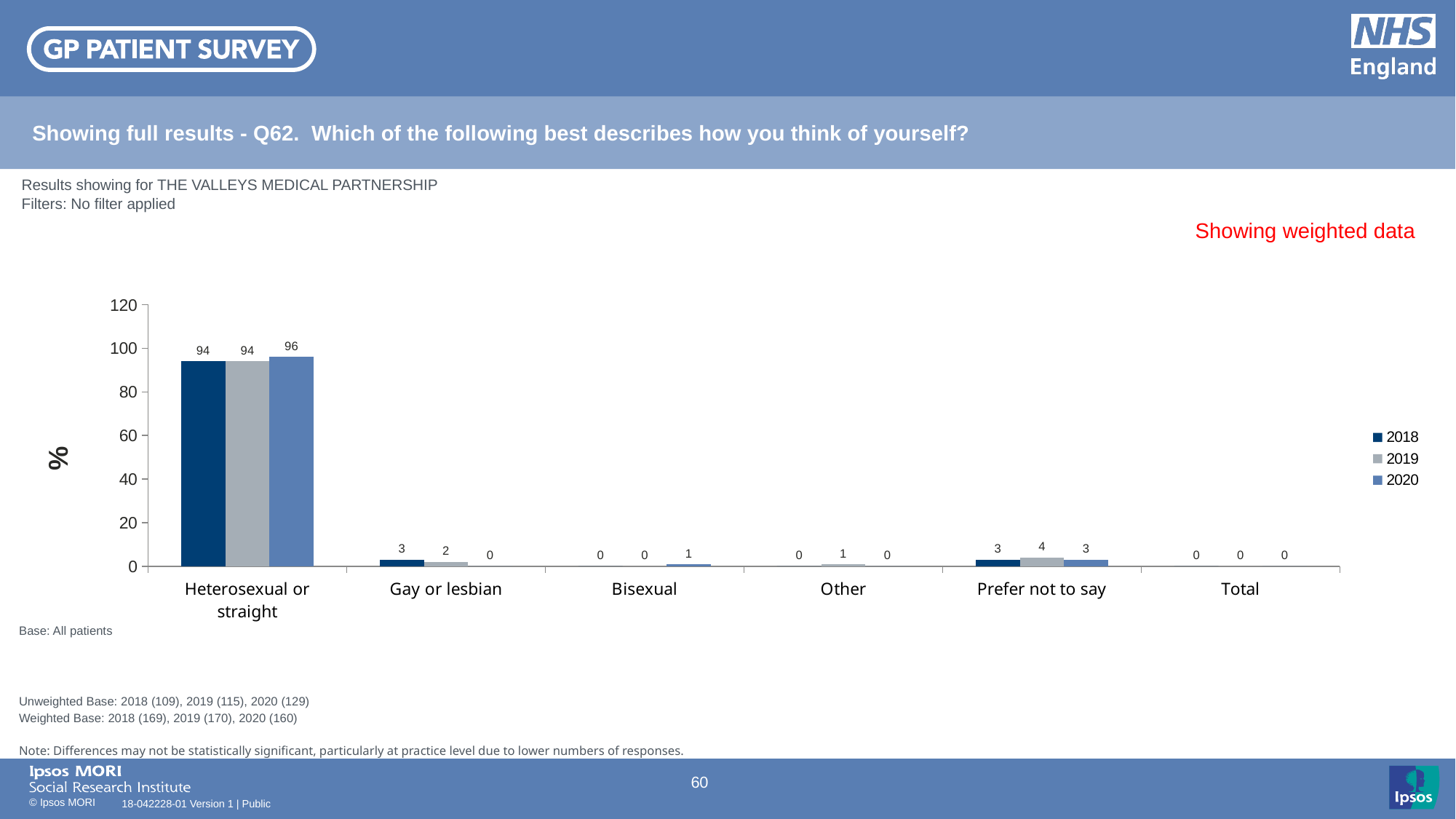
Is the value for Heterosexual or straight in 2018 greater or less than 80? greater What kind of chart is shown on the slide? Bar chart Which category has the highest value in 2019? Heterosexual or straight What is the value for Gay or lesbian in 2018? 3 How many categories are shown on the x axis? 6 What is the value for Heterosexual or straight in 2020? 96 What is the value for Prefer not to say in 2019? 4 What is the value for Bisexual in 2020? 1 How many series does the legend list? 3 Which is larger for Gay or lesbian: the 2018 value or the 2019 value? 2018 What is the difference between the 2020 and 2018 values for Heterosexual or straight? 2 What is the label on the y axis? %